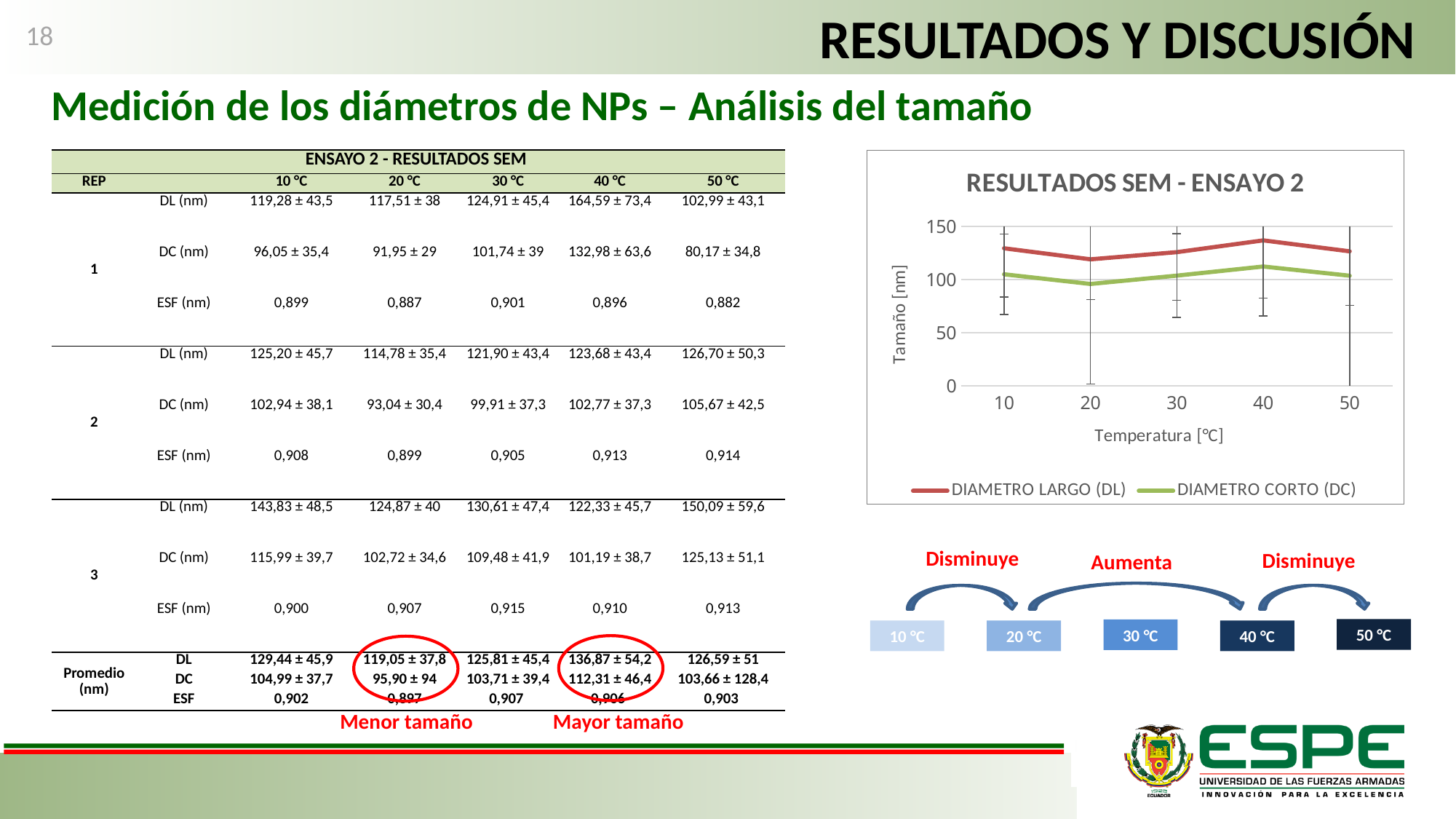
What kind of chart is shown on the slide? line chart How many temperature points are plotted along the x axis of the chart? 5 At which temperature is the DIAMETRO LARGO (DL) series highest? 40 At 30 °C, which series has the larger value, DIAMETRO LARGO (DL) or DIAMETRO CORTO (DC)? DIAMETRO LARGO (DL) Does the DIAMETRO LARGO (DL) series rise or fall from 10 °C to 20 °C? fall Is the value for DIAMETRO CORTO (DC) at 40 °C greater or less than 150? less Is the value for DIAMETRO LARGO (DL) at 40 °C greater or less than 100? greater How many series does the chart legend list? 2 At which temperature is the DIAMETRO LARGO (DL) series lowest? 20 What is the label of the x axis of the chart? Temperatura [°C] What is the title of the chart? RESULTADOS SEM - ENSAYO 2 At which temperature is the DIAMETRO CORTO (DC) series lowest? 20